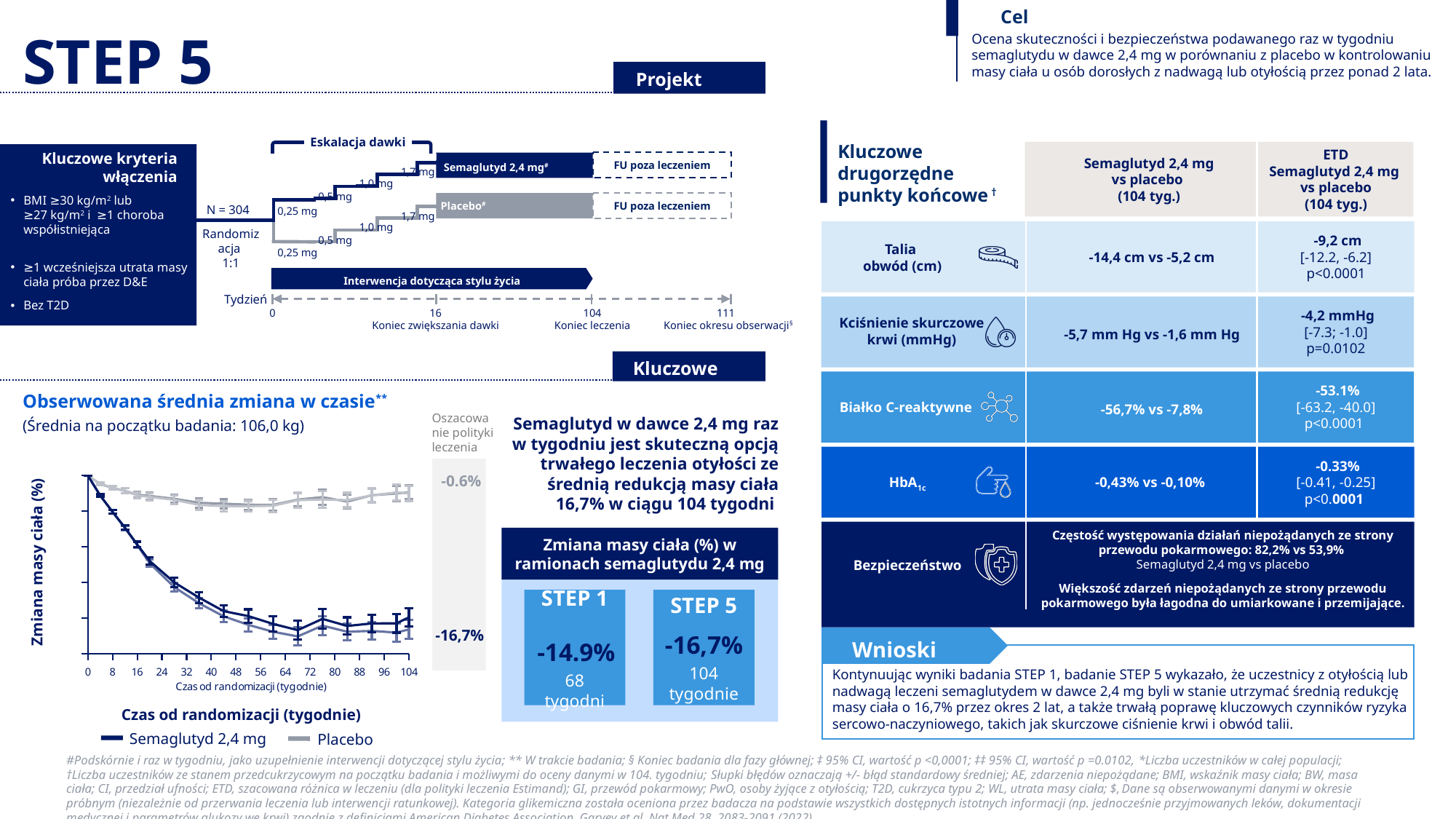
What kind of chart is 'Obserwowana średnia zmiana w czasie'? line chart In the 'Obserwowana średnia zmiana w czasie' chart, what is the estimated change in body weight for Placebo at the end of the curve? -0.6% What is the mean baseline body weight stated under the title of the 'Obserwowana średnia zmiana w czasie' chart? 106,0 kg How many series does the legend of the 'Obserwowana średnia zmiana w czasie' chart list? 2 In the 'Obserwowana średnia zmiana w czasie' chart, does the Semaglutyd 2,4 mg line rise or fall over the first 64 weeks? fall What is the last week shown on the x axis of the 'Obserwowana średnia zmiana w czasie' chart? 104 What is the label of the x axis of the 'Obserwowana średnia zmiana w czasie' chart? Czas od randomizacji (tygodnie) In the 'Obserwowana średnia zmiana w czasie' chart, which series shows the larger reduction in body weight at week 104? Semaglutyd 2,4 mg In the 'Obserwowana średnia zmiana w czasie' chart, what is the estimated change in body weight for Semaglutyd 2,4 mg at the end of the curve? -16,7% In the 'Obserwowana średnia zmiana w czasie' chart, what is the difference between the final values for Semaglutyd 2,4 mg (-16,7%) and Placebo (-0.6%)? 16.1 percentage points